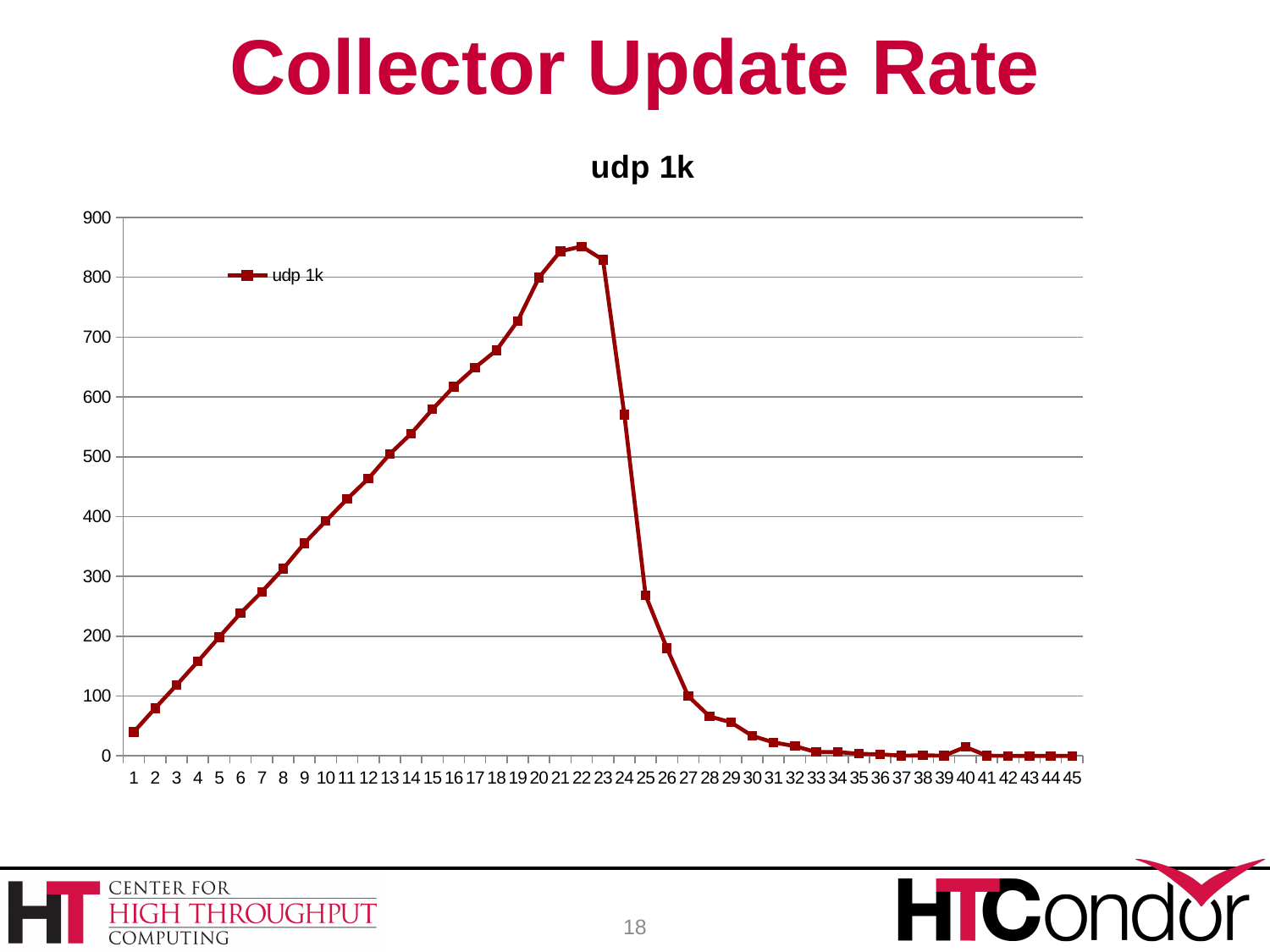
Is the value at x = 20 greater or less than 700? greater Is the value at x = 15 greater or less than 500? greater Is the value at x = 30 greater or less than 100? less Do the values rise or fall from x = 23 to x = 35? fall Which has the larger value, x = 20 or x = 30? 20 How many points are plotted along the x axis? 45 How many series does the legend list? 1 What is the title of the chart? udp 1k What kind of chart is shown on the slide? line chart Do the values rise or fall from x = 1 to x = 20? rise